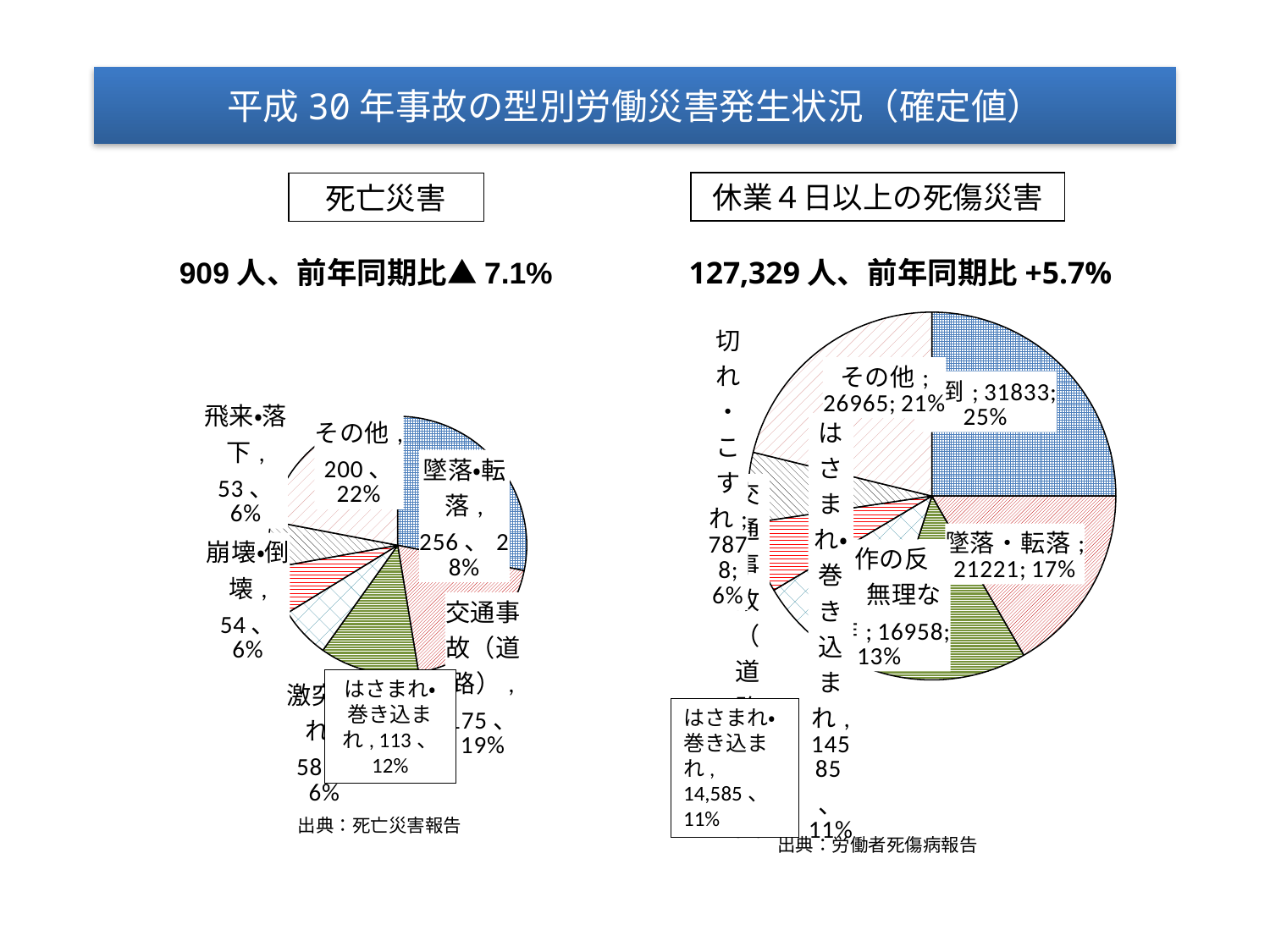
In the 死亡災害 chart on the left, what is the value for 墜落・転落? 256 In the 死亡災害 chart on the left, which is larger, 飛来・落下 or 崩壊・倒壊? 崩壊・倒壊 In the 死亡災害 chart on the left, which category has the largest value? 墜落・転落 In the 休業４日以上の死傷災害 chart on the right, what is the value for はさまれ・巻き込まれ? 14,585 In the 休業４日以上の死傷災害 chart on the right, what share of the pie is その他? 21% In the 死亡災害 chart on the left, what share of the pie is 墜落・転落? 28% In the 死亡災害 chart on the left, what is the value for その他? 200 What kind of chart is the 死亡災害 chart on the left? pie chart In the 休業４日以上の死傷災害 chart on the right, what is the value for 墜落・転落? 21221 In the 死亡災害 chart on the left, what is the difference between 墜落・転落 and その他? 56 In the 休業４日以上の死傷災害 chart on the right, which is larger, 墜落・転落 or その他? その他 In the 死亡災害 chart on the left, what is the value for はさまれ・巻き込まれ? 113